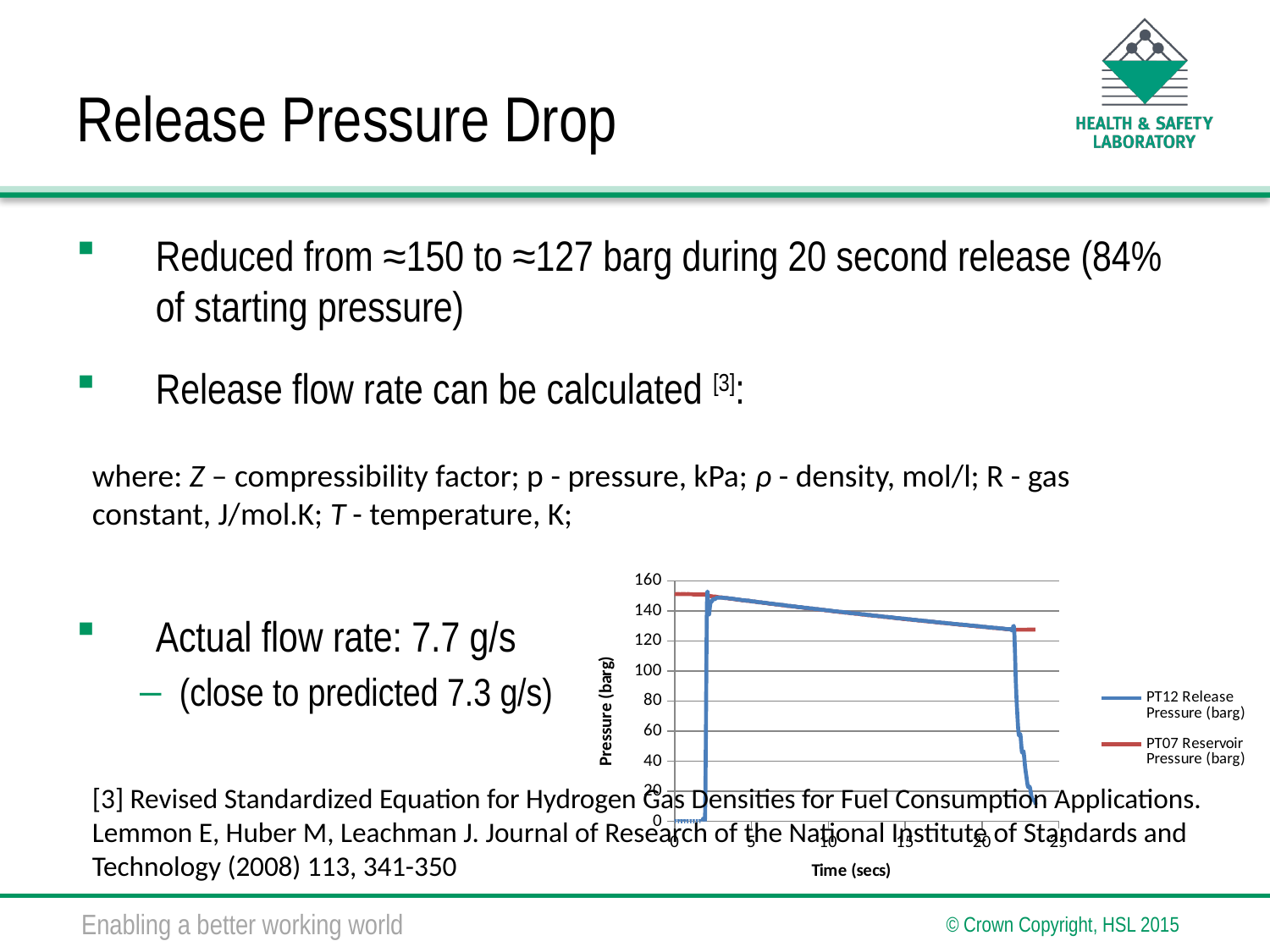
Which series is plotted in blue, PT12 Release Pressure or PT07 Reservoir Pressure? PT12 Release Pressure (barg) Is the PT07 Reservoir Pressure value at 0 seconds greater or less than 140? greater Is the PT12 Release Pressure value at 0 seconds greater or less than 20? less How many series does the chart legend list? 2 Between 5 and 20 seconds, does the PT12 Release Pressure line rise or fall as time increases? fall Is the PT12 Release Pressure value at 15 seconds greater or less than 160? less What is the title of the chart's vertical axis? Pressure (barg) What are the two series named in the chart legend? PT12 Release Pressure (barg) and PT07 Reservoir Pressure (barg) What kind of chart is shown on the slide? line chart